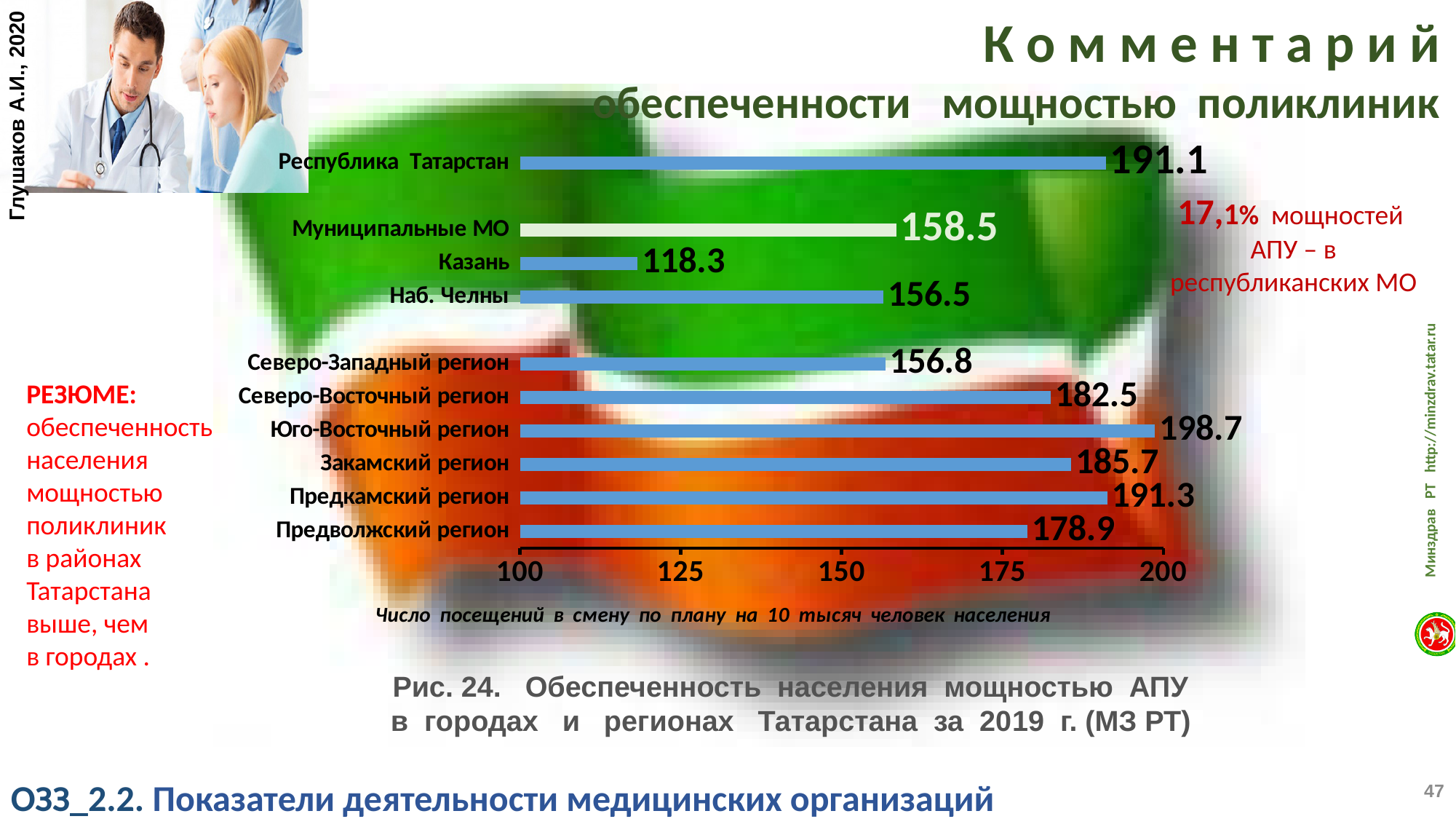
What is the value for Казань? 118.3 What kind of chart is shown on the slide? bar chart What is the x-axis label of the chart? Число посещений в смену по плану на 10 тысяч человек населения Which is larger, the value for Наб. Челны or the value for Северо-Восточный регион? Северо-Восточный регион What is the value for Юго-Восточный регион? 198.7 Which category has the highest value? Юго-Восточный регион Is the value for Предкамский регион greater or less than 175? greater What is the value for Республика Татарстан? 191.1 What is the value for Муниципальные МО? 158.5 What is the difference between the values for Закамский регион and Предволжский регион? 6.8 How many categories are shown in the chart? 10 Which category has the lowest value? Казань